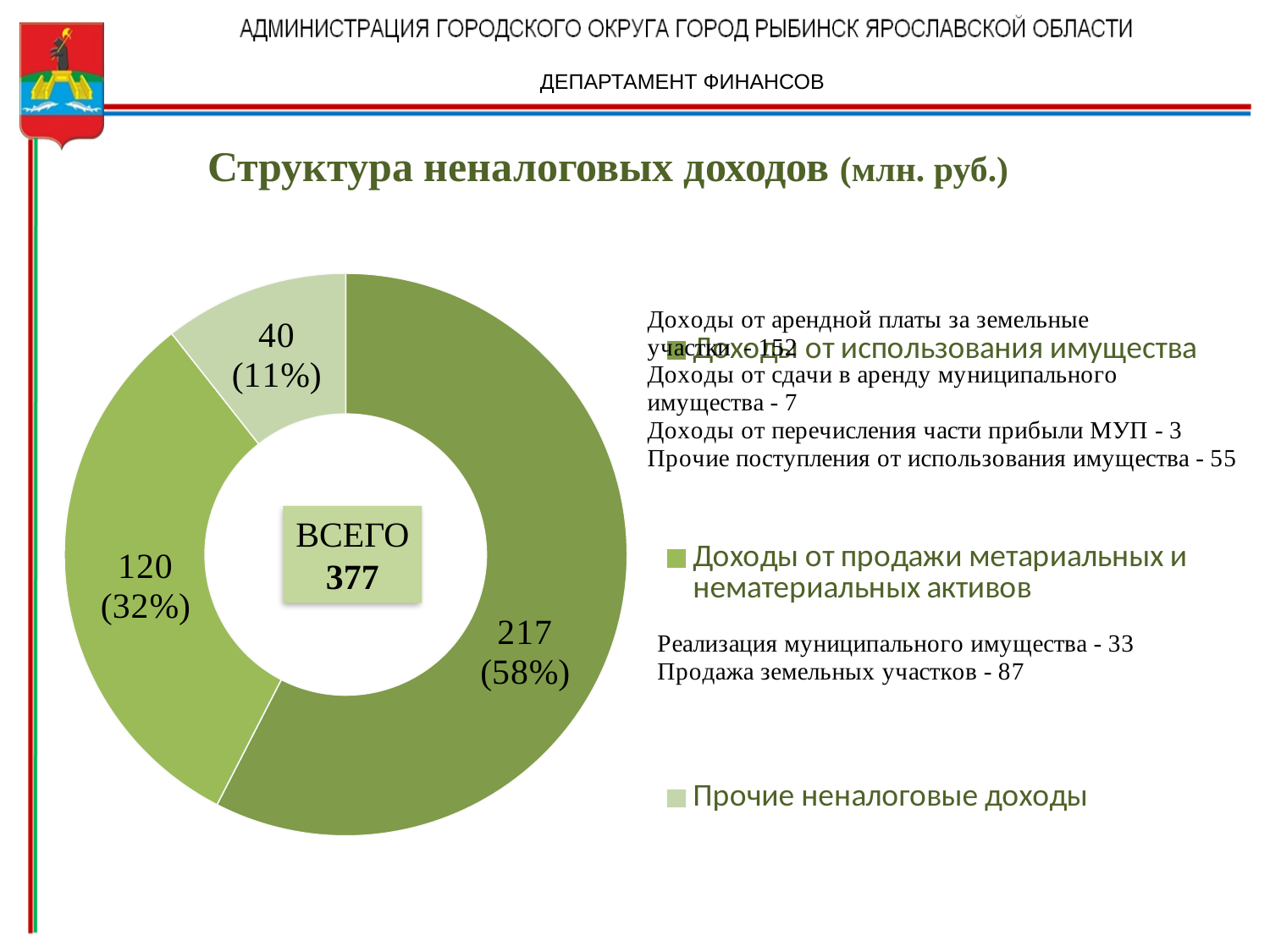
What total (ВСЕГО) is shown in the centre of the chart? 377 What is the value for "Доходы от использования имущества"? 217 Which category has the largest slice? Доходы от использования имущества What share of the chart does "Доходы от использования имущества" take? 58% What share of the chart does "Прочие неналоговые доходы" take? 11% What is the difference between the values for "Доходы от использования имущества" and "Доходы от продажи метариальных и нематериальных активов"? 97 What is the value for "Прочие неналоговые доходы"? 40 How many slices does the chart have? 3 What is the value for "Доходы от продажи метариальных и нематериальных активов"? 120 Which category has the smallest slice? Прочие неналоговые доходы What kind of chart is shown on the slide? Doughnut (pie) chart Which is larger: "Доходы от продажи метариальных и нематериальных активов" or "Прочие неналоговые доходы"? Доходы от продажи метариальных и нематериальных активов